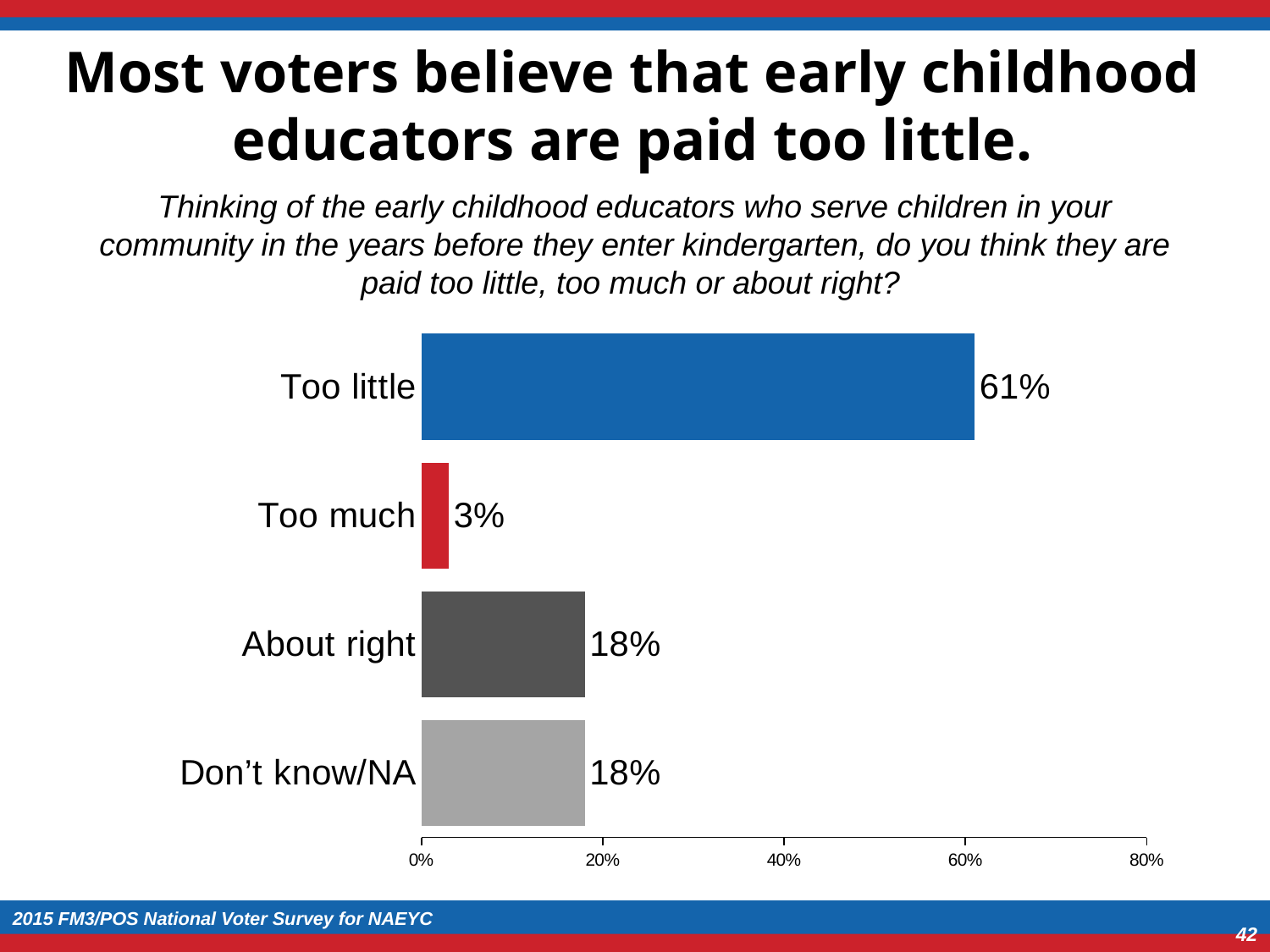
Which is larger, the value for 'Too little' or the value for 'Don't know/NA'? Too little Is the value for 'Too little' greater or less than 60%? greater Which response category has the highest percentage? Too little What kind of chart is shown on the slide? Bar chart What percentage of voters answered Don't know/NA? 18% How many response categories are shown in the chart? 4 What is the difference in percentage points between 'Too little' and 'About right'? 43 What percentage of voters said early childhood educators are paid too little? 61% What percentage of voters said early childhood educators are paid too much? 3% What is the difference in percentage points between 'About right' and 'Too much'? 15 What percentage of voters said early childhood educators are paid about right? 18% Which response category has the lowest percentage? Too much